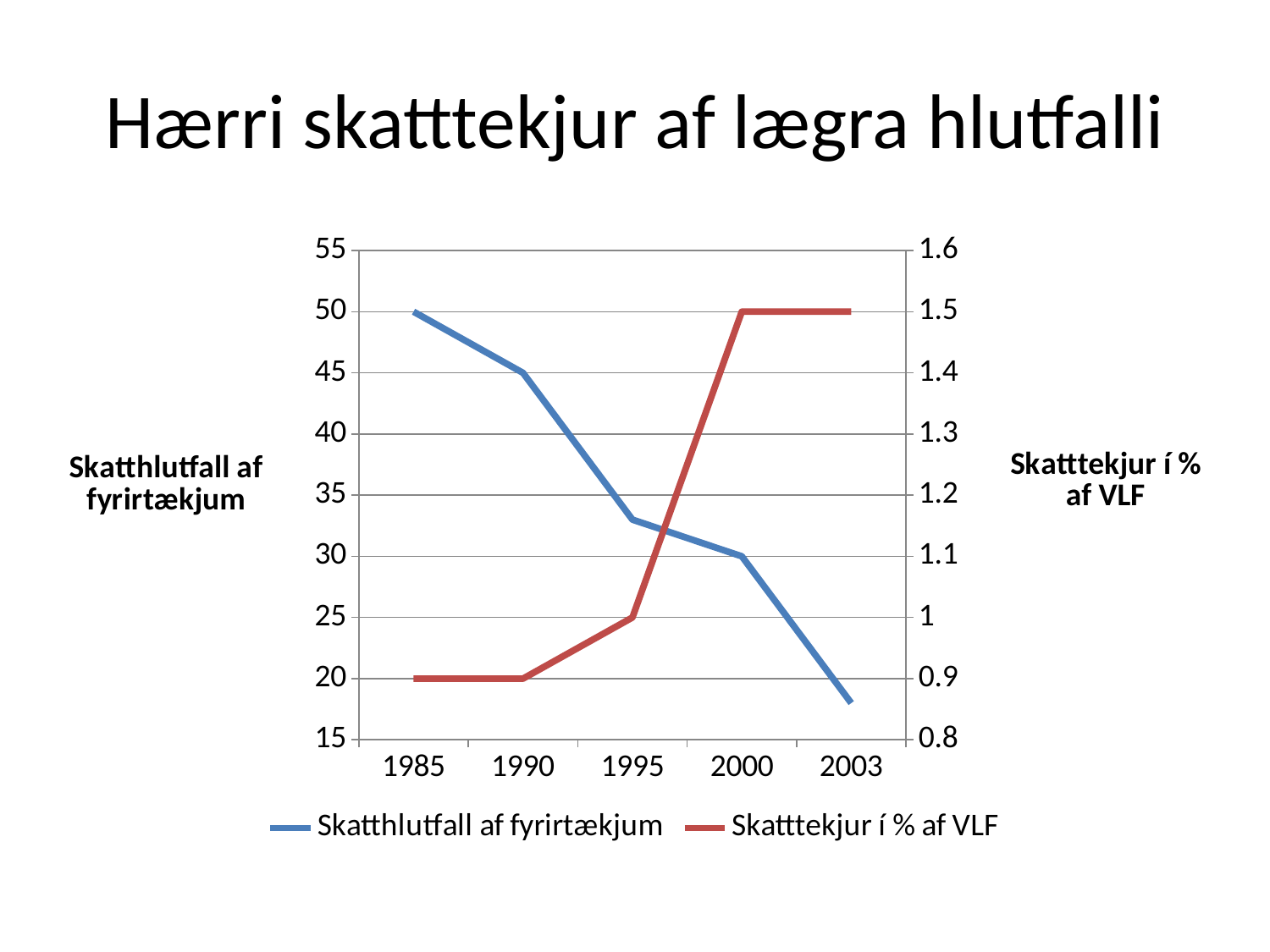
What is the value of Skatttekjur í % af VLF in 1985? 0.9 What type of chart is shown on the slide? line chart What is the value of Skatthlutfall af fyrirtækjum in 1990? 45 By how much did Skatttekjur í % af VLF rise between 1985 and 2000? 0.6 How many years are plotted along the x axis? 5 What is the value of Skatthlutfall af fyrirtækjum in 1985? 50 Is the value for Skatthlutfall af fyrirtækjum in 2003 greater or less than 20? less Does Skatthlutfall af fyrirtækjum rise or fall from 1985 to 2003? fall By how much did Skatthlutfall af fyrirtækjum fall between 1985 and 1990? 5 What is the value of Skatttekjur í % af VLF in 2000? 1.5 How many series does the legend list? 2 In which year is Skatthlutfall af fyrirtækjum highest? 1985